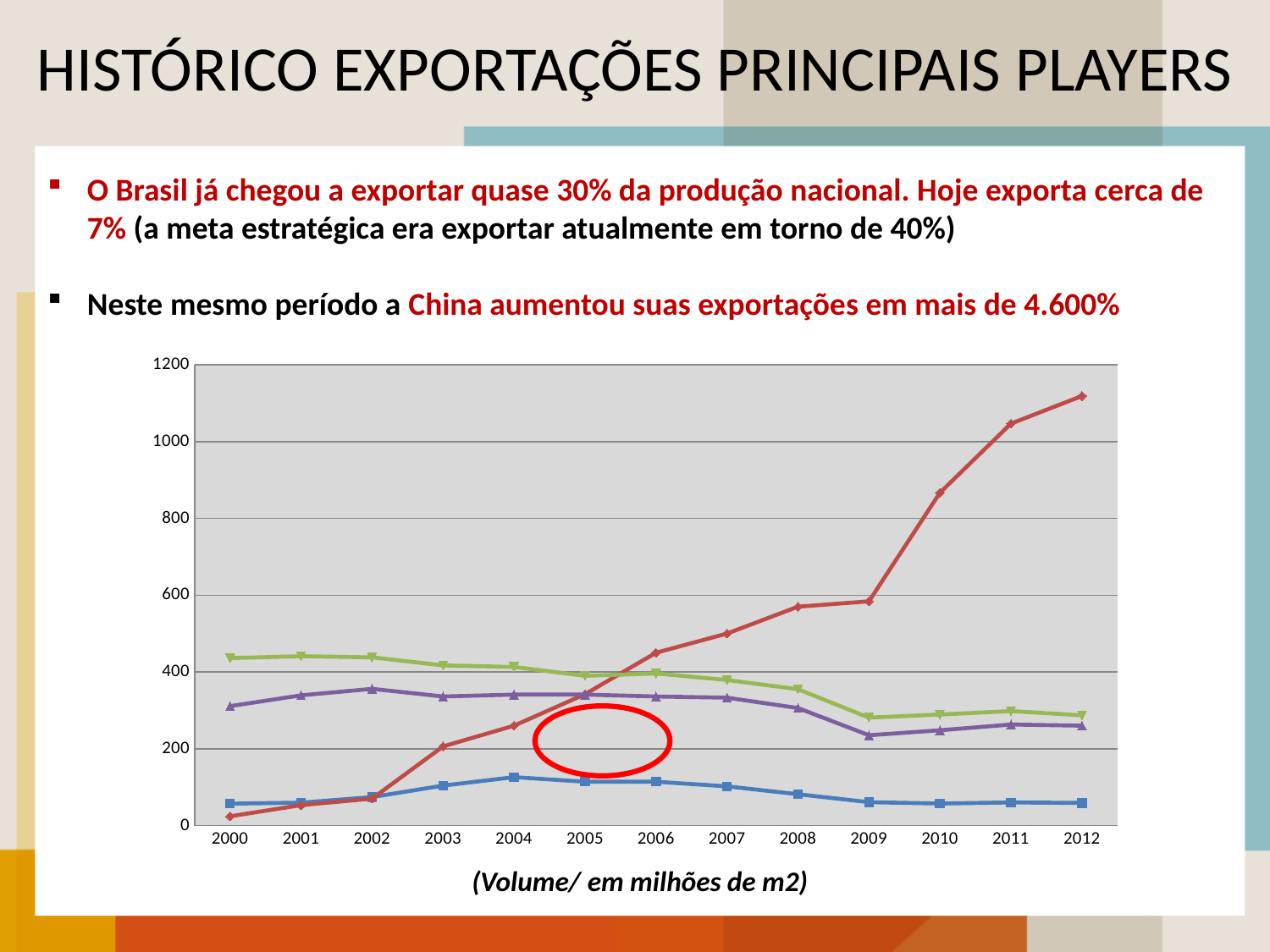
Is the value of the red line in 2000 greater or less than 200? less Which line has the highest value in 2012? the red line Is the value of the red line in 2012 greater or less than 1000? greater Is the value of the green line in 2000 greater or less than 400? greater Does the green line rise or fall from 2000 to 2012? falls Which line has the lowest value in 2012? the blue line In 2012, which is larger: the red line or the green line? the red line Does the red line rise or fall from 2000 to 2012? rises What kind of chart is shown on the slide? line chart What unit caption is printed below the chart? (Volume/ em milhões de m2) How many years are shown along the x axis of the chart? 13